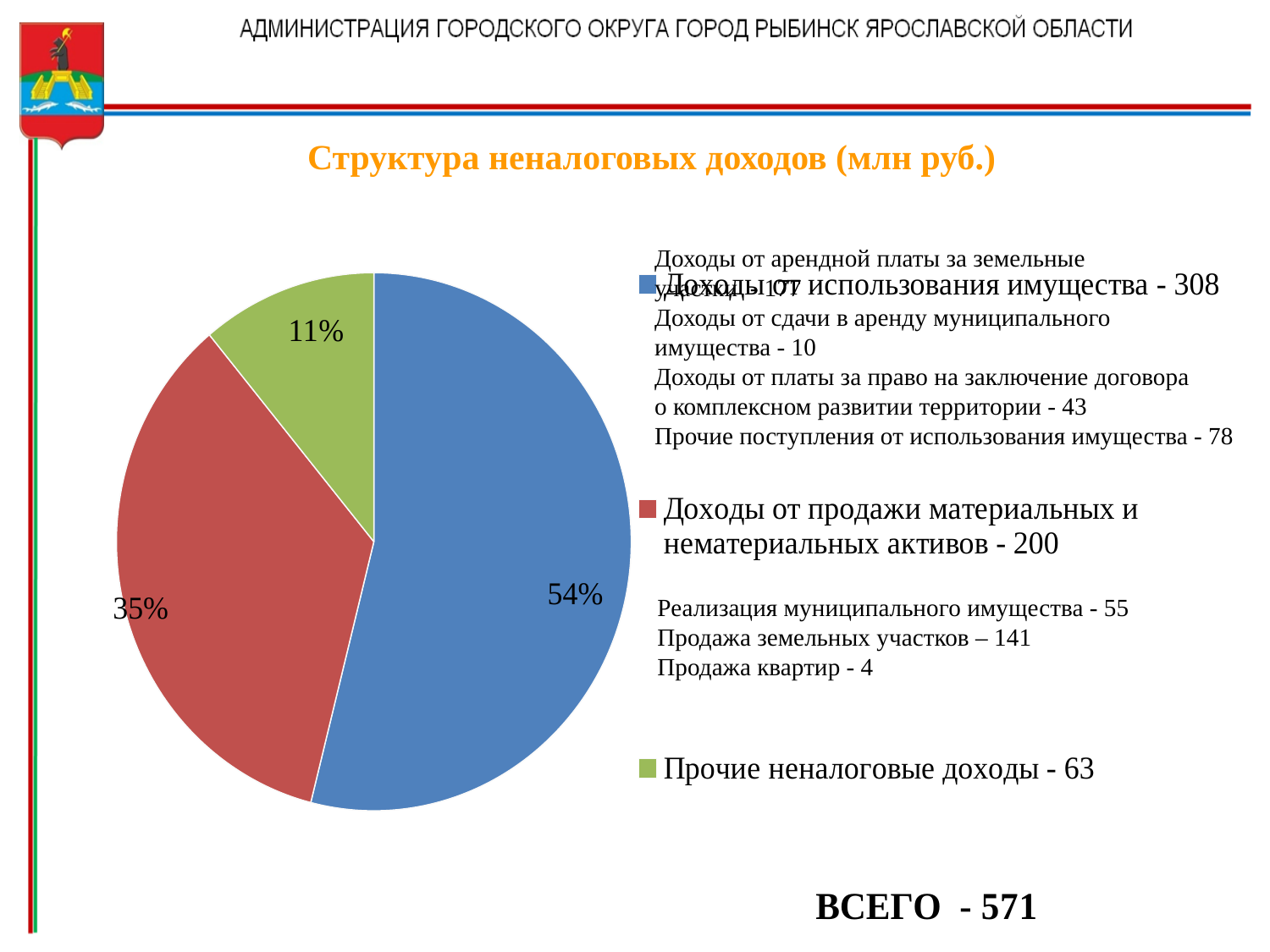
What value (млн руб.) does the legend give for 'Прочие неналоговые доходы'? 63 What kind of chart is shown on the slide? pie chart What share of the pie is labelled for 'Прочие неналоговые доходы'? 11% Which is larger: the slice for 'Доходы от продажи материальных и нематериальных активов' or the slice for 'Прочие неналоговые доходы'? Доходы от продажи материальных и нематериальных активов What is the difference in percentage points between the 54% slice and the 35% slice? 19 What is the title of the chart? Структура неналоговых доходов (млн руб.) What share of the pie is labelled for 'Доходы от продажи материальных и нематериальных активов'? 35% Which category has the smallest slice of the pie? Прочие неналоговые доходы What share of the pie is labelled for 'Доходы от использования имущества'? 54% Which category has the largest slice of the pie? Доходы от использования имущества What value (млн руб.) does the legend give for 'Доходы от использования имущества'? 308 How many slices does the pie chart have? 3